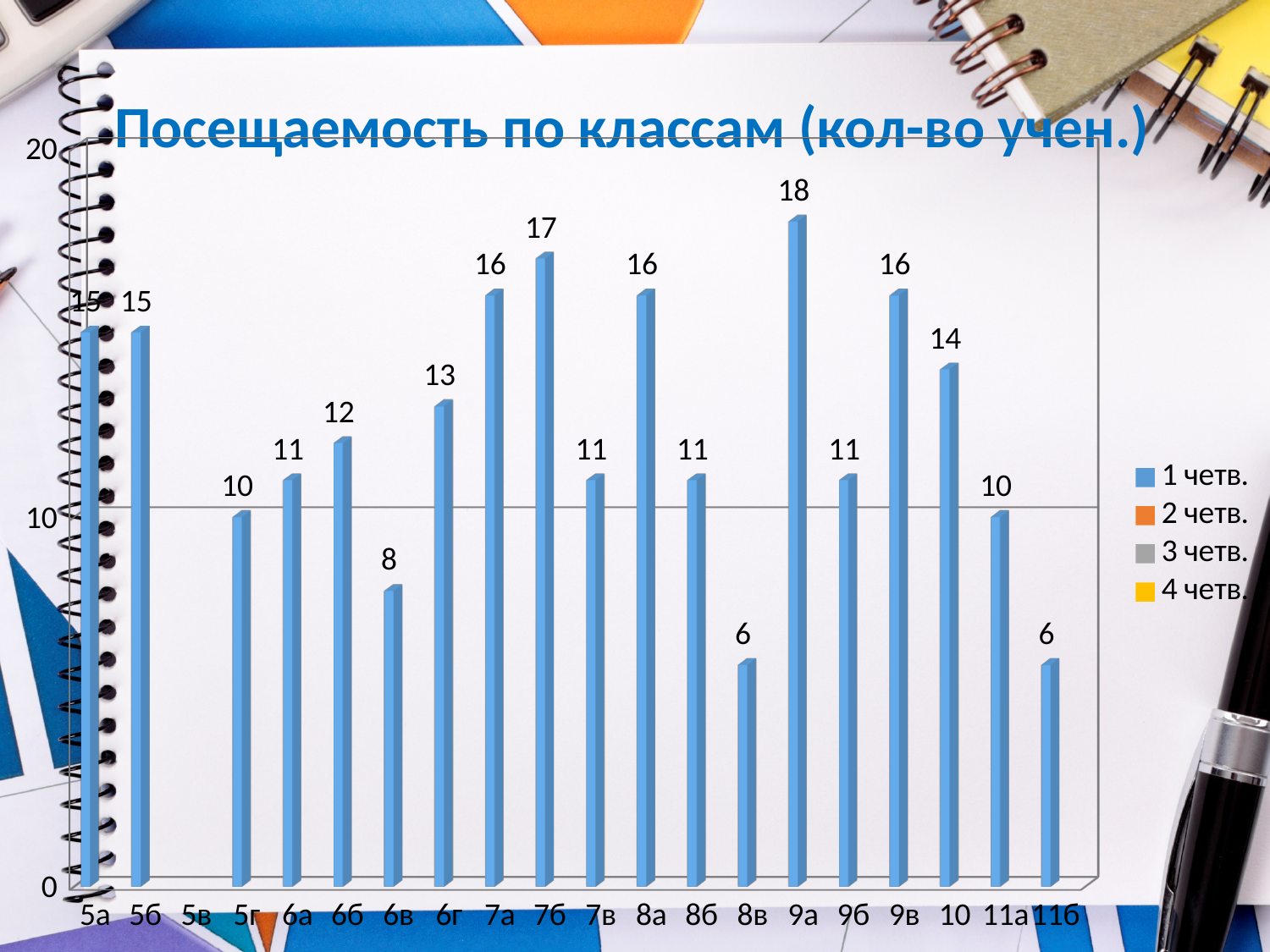
What kind of chart is shown on the slide? bar chart What is the value for class 9а? 18 What is the value for class 10? 14 Which class has the highest value? 9а Which has a larger value, 6г or 8б? 6г How many classes are listed on the x axis? 20 What is the value for class 6в? 8 How many series does the legend list? 4 Which legend entry is shown in blue? 1 четв. What is the difference between the values for 7б and 5г? 7 What is the title of the chart? Посещаемость по классам (кол-во учен.) What is the difference between the values for 9а and 11б? 12